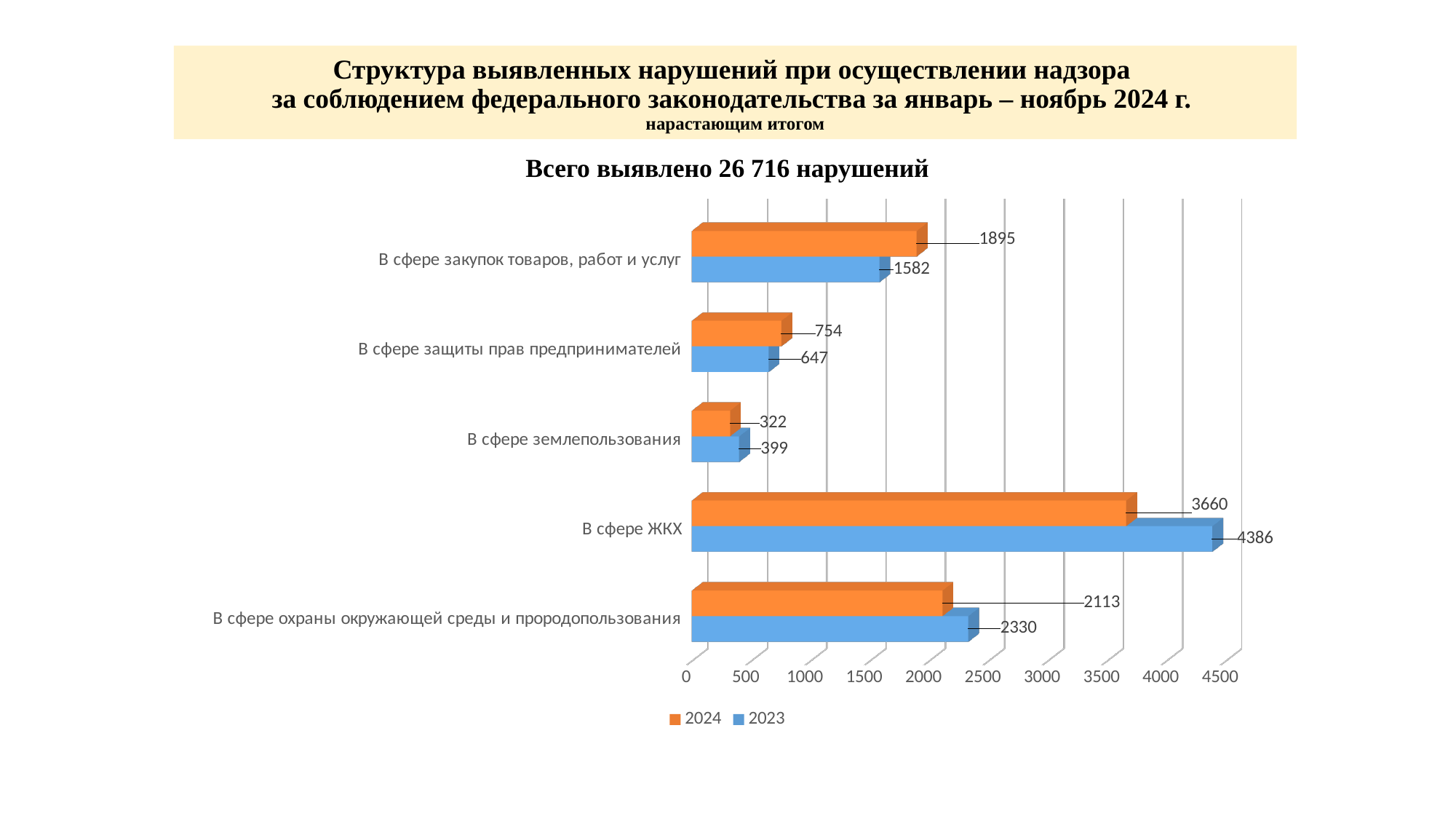
What is the 2024 value for «В сфере ЖКХ»? 3660 How many categories are shown on the chart? 5 Which category has the highest 2023 value? В сфере ЖКХ Which category has the lowest 2024 value? В сфере землепользования For «В сфере охраны окружающей среды и природопользования», which year has the larger value, 2024 or 2023? 2023 What is the difference between the 2024 and 2023 values for «В сфере защиты прав предпринимателей»? 107 Which colour represents the 2024 series? Orange What is the 2023 value for «В сфере закупок товаров, работ и услуг»? 1582 What is the difference between the 2023 and 2024 values for «В сфере ЖКХ»? 726 What kind of chart is shown on the slide? Bar chart How many series does the legend list? 2 What is the 2024 value for «В сфере землепользования»? 322